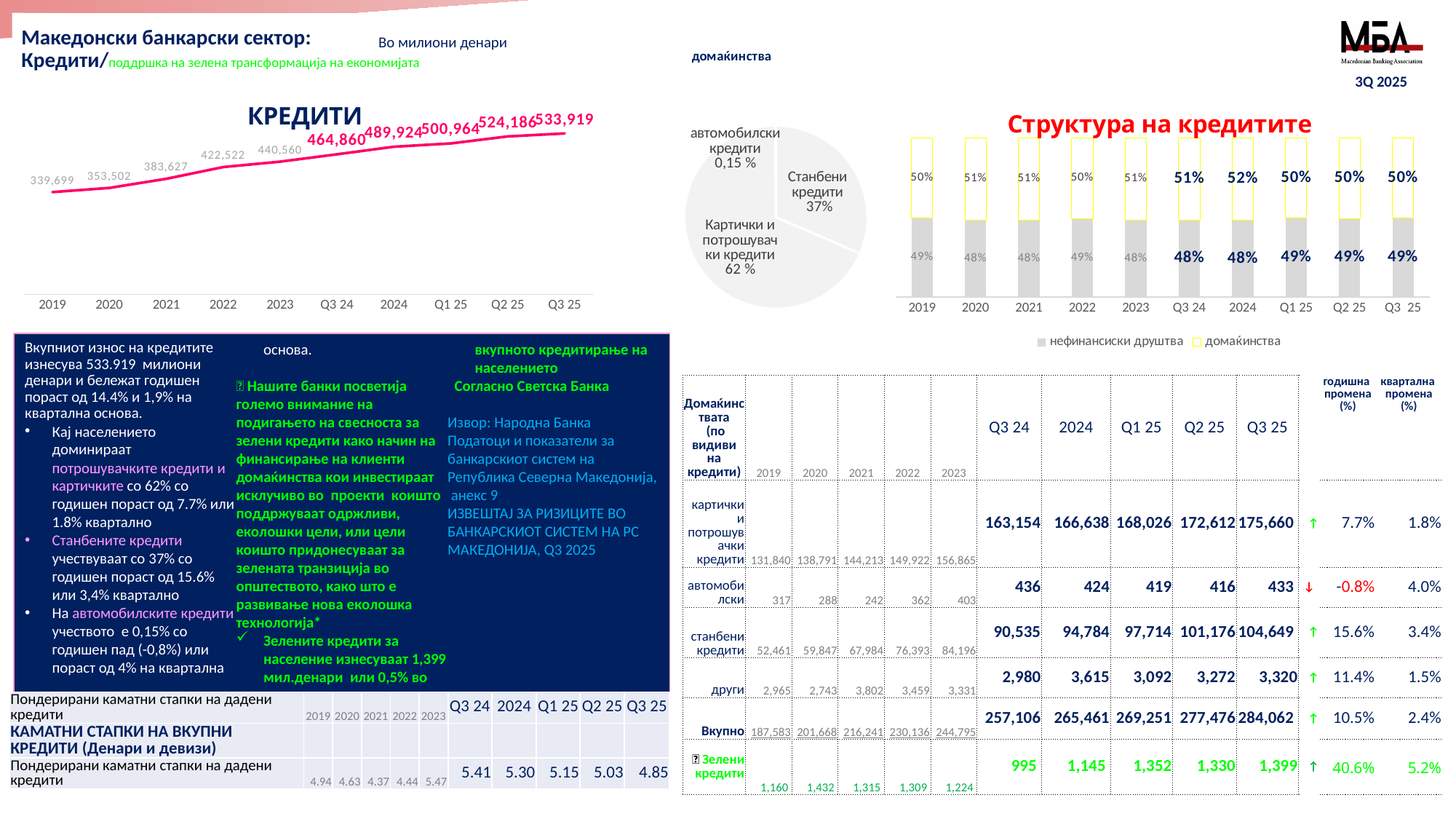
In the line chart titled КРЕДИТИ, how many periods are plotted on the x axis? 10 In the line chart titled КРЕДИТИ, what is the value for 2022? 422,522 In the stacked bar chart titled Структура на кредитите, what is the value for домаќинства in 2024? 52% In the line chart titled КРЕДИТИ, do the values rise or fall from 2019 to Q3 25? rise In the line chart titled КРЕДИТИ, what is the value for Q3 25? 533,919 In the pie chart titled домаќинства, what share do Станбени кредити have? 37% In the line chart titled КРЕДИТИ, what is the value for 2019? 339,699 In the stacked bar chart titled Структура на кредитите, how many series does the legend list? 2 In the line chart titled КРЕДИТИ, which period has the highest value? Q3 25 In the pie chart titled домаќинства, which slice is the largest? Картички и потрошувачки кредити In the line chart titled КРЕДИТИ, what is the difference between the values for Q3 25 and Q2 25? 9,733 In the pie chart titled домаќинства, what share do автомобилски кредити have? 0,15 %